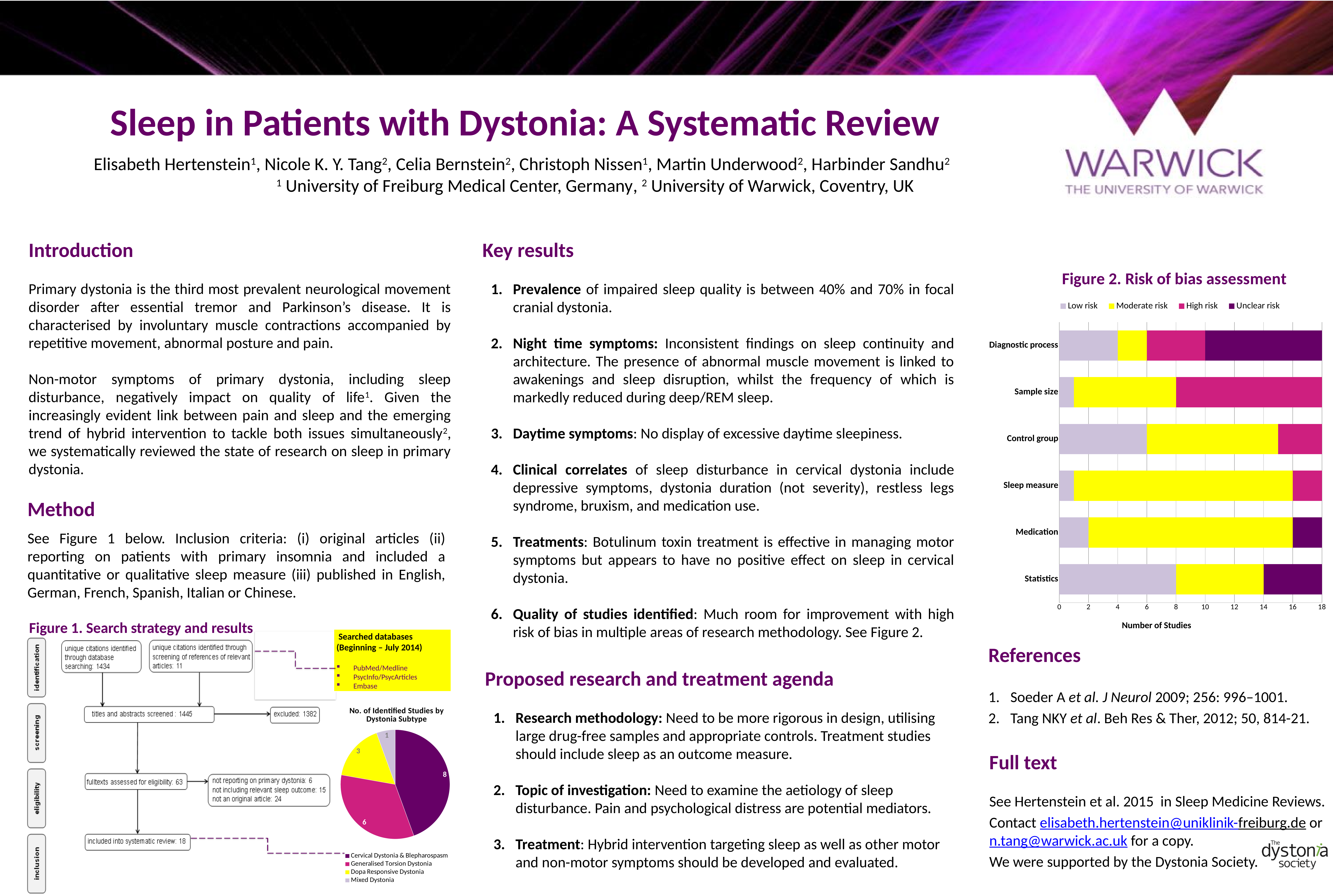
In the pie chart 'No. of Identified Studies by Dystonia Subtype', how many subtypes are shown? 4 How many series does the legend of 'Figure 2. Risk of bias assessment' list? 4 In the pie chart 'No. of Identified Studies by Dystonia Subtype', how many studies are for Generalised Torsion Dystonia? 6 In 'Figure 2. Risk of bias assessment', which category has the largest Low risk segment? Statistics In 'Figure 2. Risk of bias assessment', which category has the largest Unclear risk segment? Diagnostic process In the pie chart 'No. of Identified Studies by Dystonia Subtype', which subtype has the fewest studies? Mixed Dystonia In 'Figure 2. Risk of bias assessment', is the Low risk value for Statistics greater or less than 6? greater What kind of chart is 'Figure 2. Risk of bias assessment'? Stacked bar chart In the pie chart 'No. of Identified Studies by Dystonia Subtype', what is the total number of studies across all slices? 18 In the pie chart 'No. of Identified Studies by Dystonia Subtype', what is the difference between the number of studies for Cervical Dystonia & Blepharospasm and Dopa Responsive Dystonia? 5 In the pie chart 'No. of Identified Studies by Dystonia Subtype', how many studies are for Cervical Dystonia & Blepharospasm? 8 How many categories are shown on the y axis of 'Figure 2. Risk of bias assessment'? 6